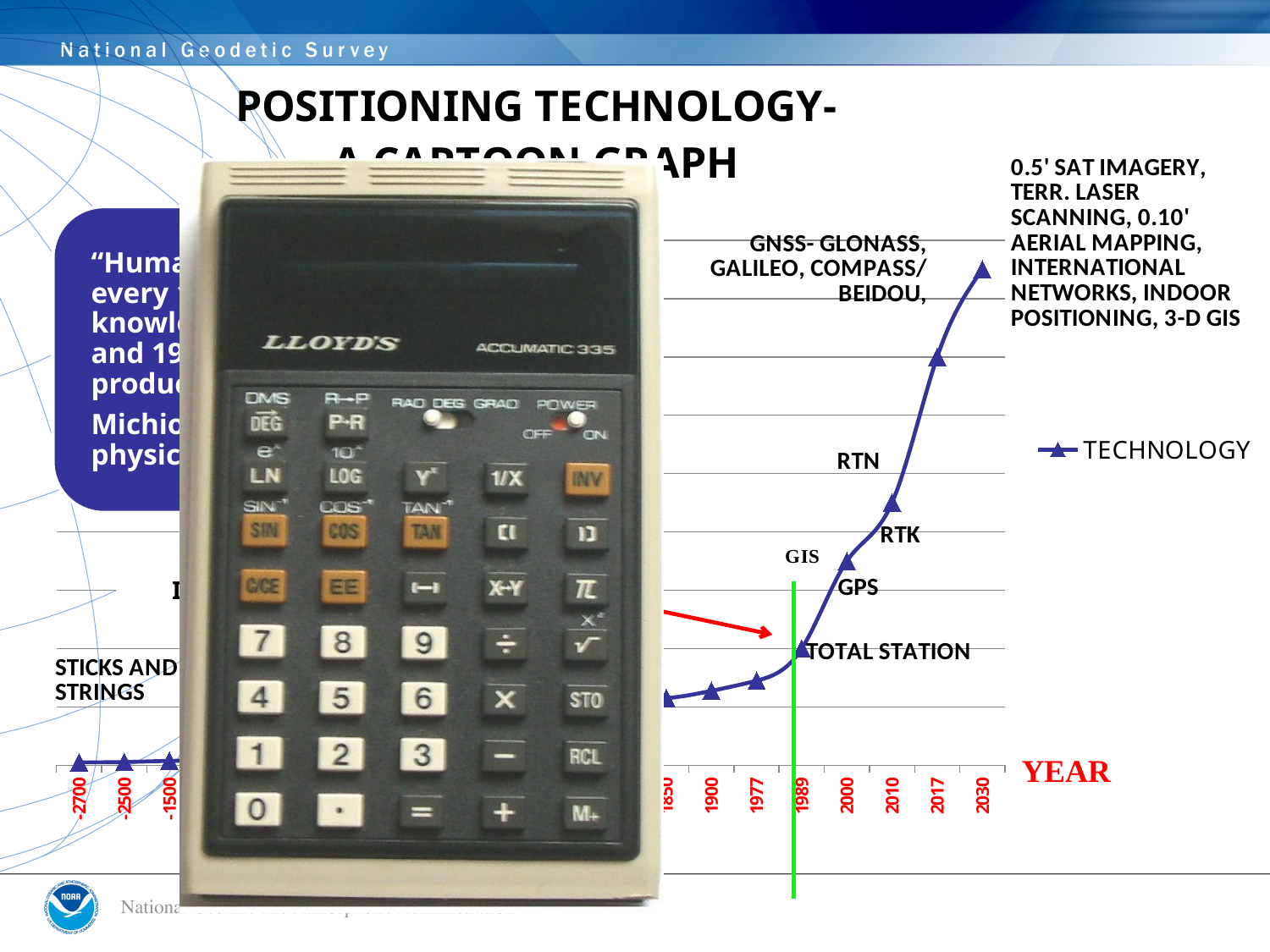
What kind of chart is shown on the slide? line chart Which has the larger plotted value, 1900 or 2030? 2030 Which has the larger plotted value, 1977 or 2017? 2017 Which year has the highest plotted value on the TECHNOLOGY line? 2030 What is the title of the chart's x axis? YEAR How many series does the chart's legend list? 1 What is the name of the series listed in the chart's legend? TECHNOLOGY Do the plotted values rise or fall as the year increases along the x axis? rise